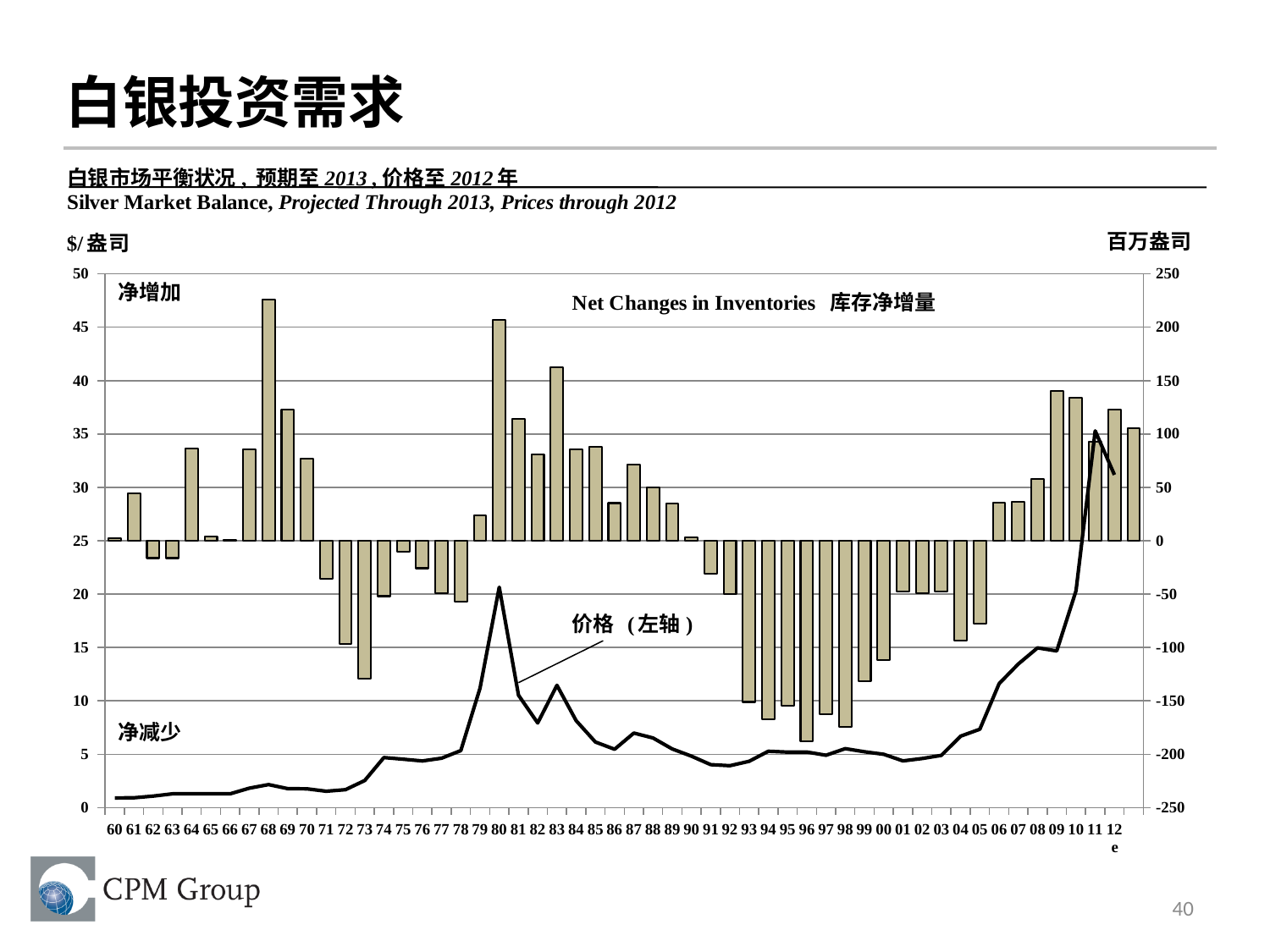
Which year has the larger net change in inventories bar, 80 or 83? 80 Is the price (left axis) in 60 greater or less than $5 per ounce? less Which year has the highest bar for net changes in inventories? 68 Is the price (left axis) in 80 greater or less than $15 per ounce? greater Is the net change in inventories bar for 68 greater or less than 200 million ounces? greater Does the price line rise or fall from 05 to 11? rise In which year does the price line reach its highest point? 11 What unit is shown on the right-hand axis of the chart? 百万盎司 Which year has the lowest (most negative) bar for net changes in inventories? 96 What kind of chart is shown on the slide? A combined bar and line chart